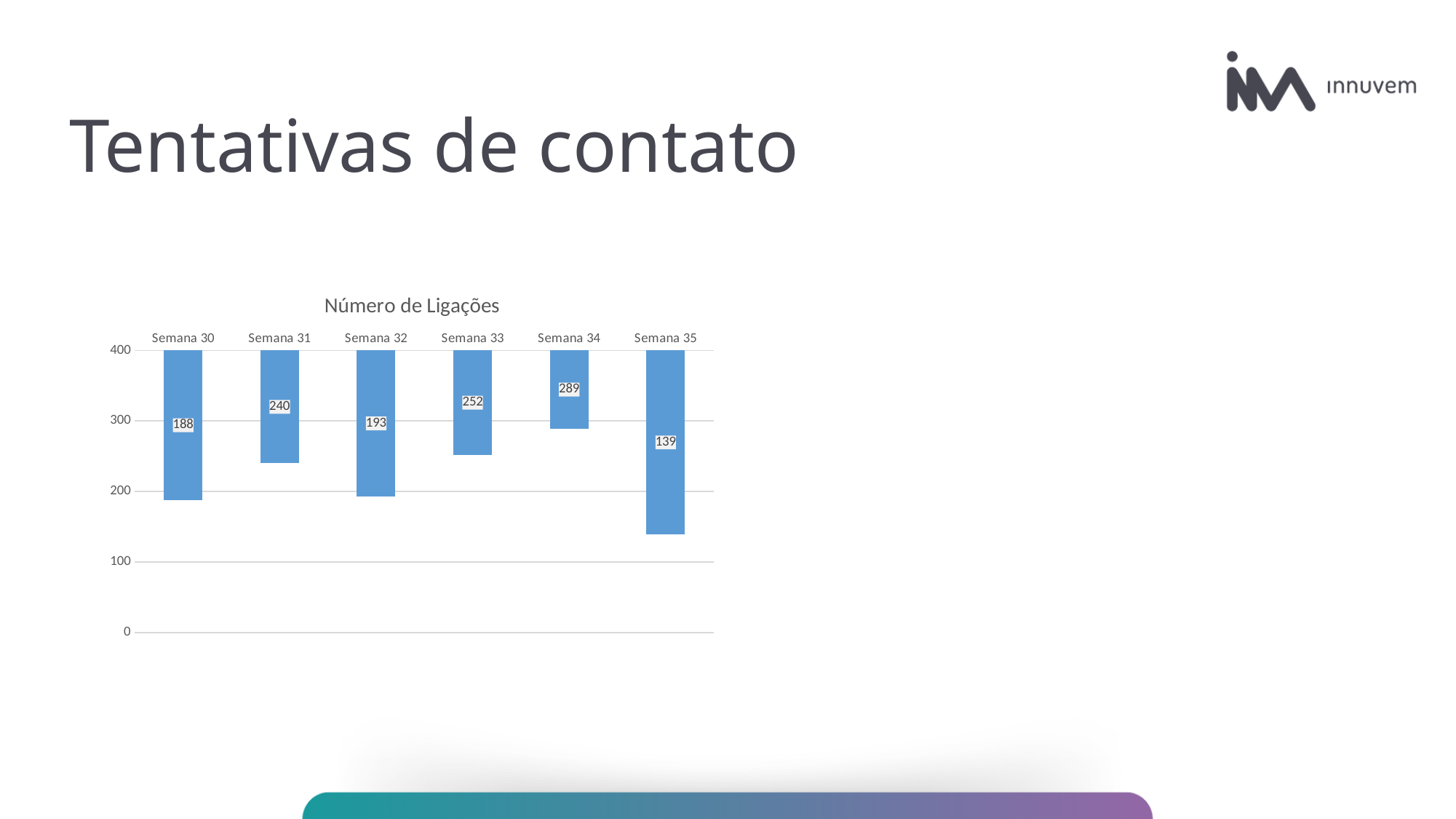
What kind of chart is shown on the slide? Bar chart What is the difference between the values for Semana 34 and Semana 35? 150 What is the title of the chart on the slide? Número de Ligações What is the value for Semana 35 in the Número de Ligações chart? 139 Which week has the highest number of calls in the chart? Semana 34 What is the value for Semana 30 in the Número de Ligações chart? 188 Which is larger, the value for Semana 31 or the value for Semana 32? Semana 31 What is the difference between the values for Semana 31 and Semana 30? 52 Which week has the lowest number of calls in the chart? Semana 35 Do the values rise or fall from Semana 32 to Semana 34? Rise How many weeks are shown in the chart? 6 What is the value for Semana 33 in the Número de Ligações chart? 252